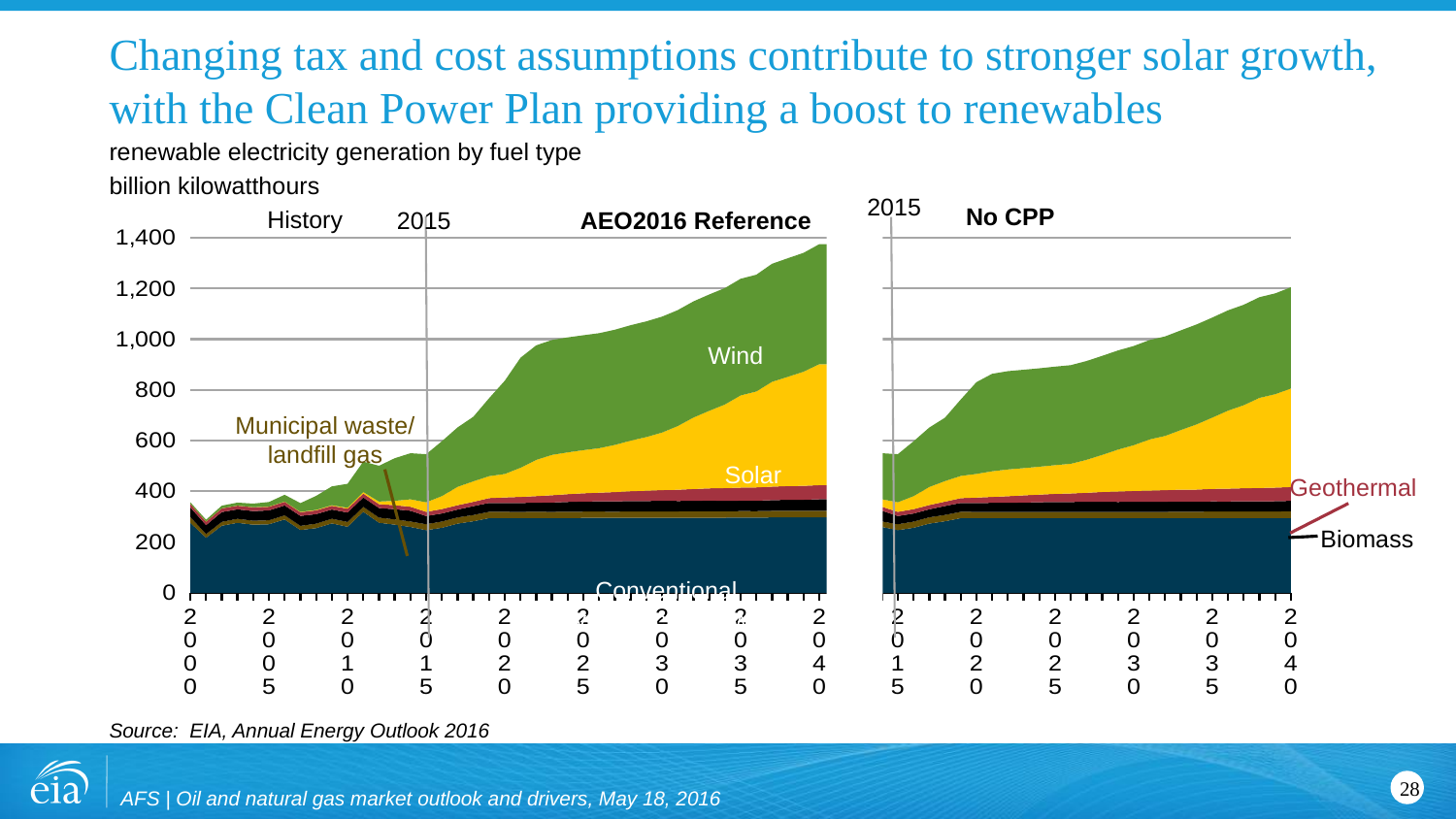
What are the titles of the two projection panels on the slide? AEO2016 Reference and No CPP In the No CPP chart, is total renewable generation in 2040 greater or less than 1,000 billion kilowatthours? greater What kind of chart is used on this slide to show renewable electricity generation? Stacked area chart In the AEO2016 Reference chart, is total renewable generation in 2040 greater or less than 1,200 billion kilowatthours? greater How many fuel types are labeled across the charts on the slide? 6 In the AEO2016 Reference chart, is total renewable generation in 2000 greater or less than 400 billion kilowatthours? less Which scenario shows higher total renewable generation in 2040, AEO2016 Reference or No CPP? AEO2016 Reference In the No CPP chart, does total renewable generation rise or fall between 2015 and 2040? Rise What unit is used on the y axis of the charts? billion kilowatthours In the AEO2016 Reference chart, does total renewable generation rise or fall between 2015 and 2040? Rise